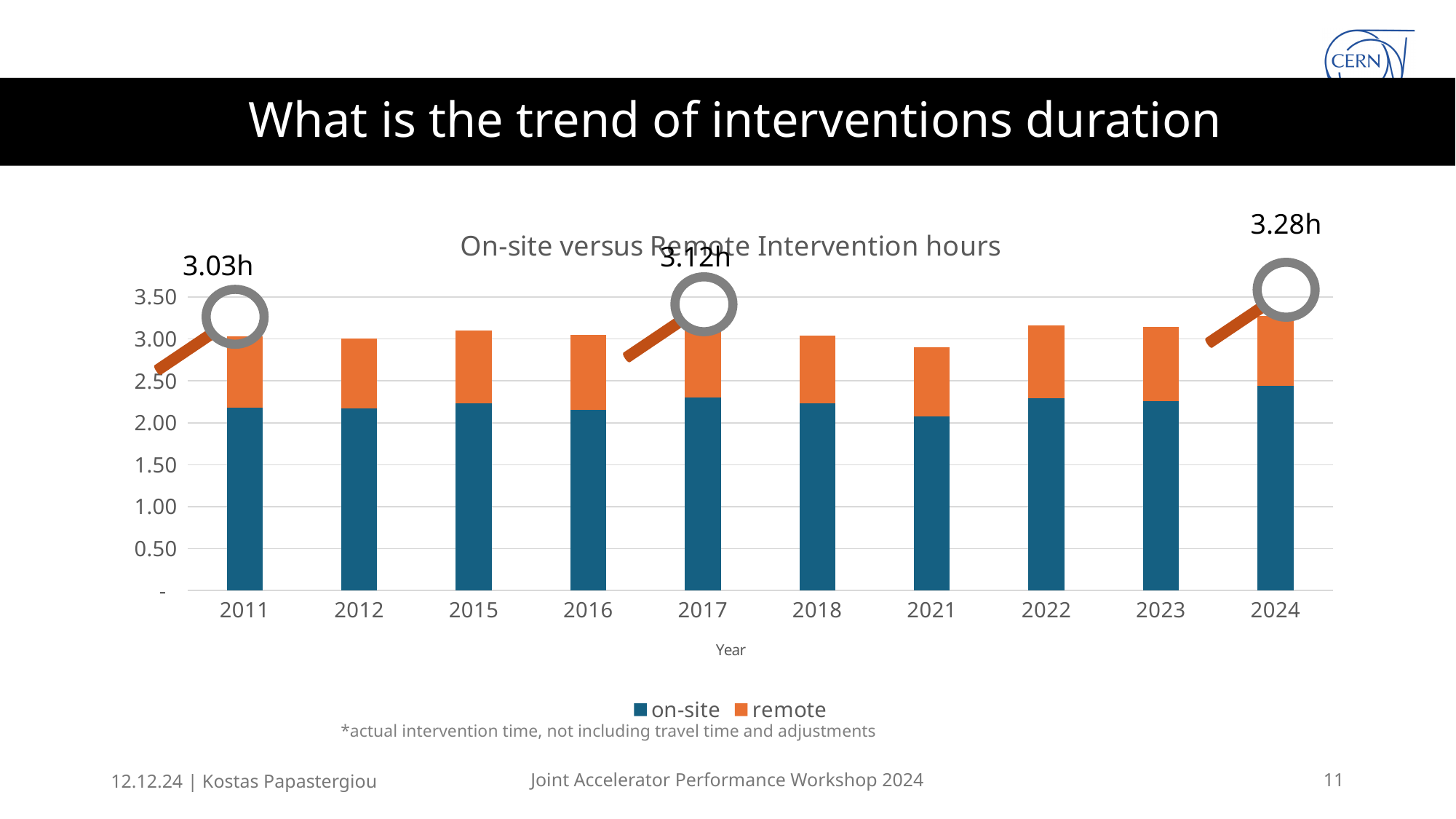
What kind of chart is shown on the slide? bar chart How many series does the legend list? 2 Is the total intervention hours value for 2021 greater or less than 3.00? less How many years are shown on the x axis of the chart? 10 What total intervention duration is annotated for 2011? 3.03h What is the title of the chart? On-site versus Remote Intervention hours Which year has the tallest stacked bar (highest total intervention hours)? 2024 Which year has the shortest stacked bar (lowest total intervention hours)? 2021 Do the annotated total durations rise or fall from 2011 through 2017 to 2024? rise What total intervention duration is annotated for 2024? 3.28h What is the difference between the annotated totals for 2024 and 2011? 0.25h What total intervention duration is annotated for 2017? 3.12h